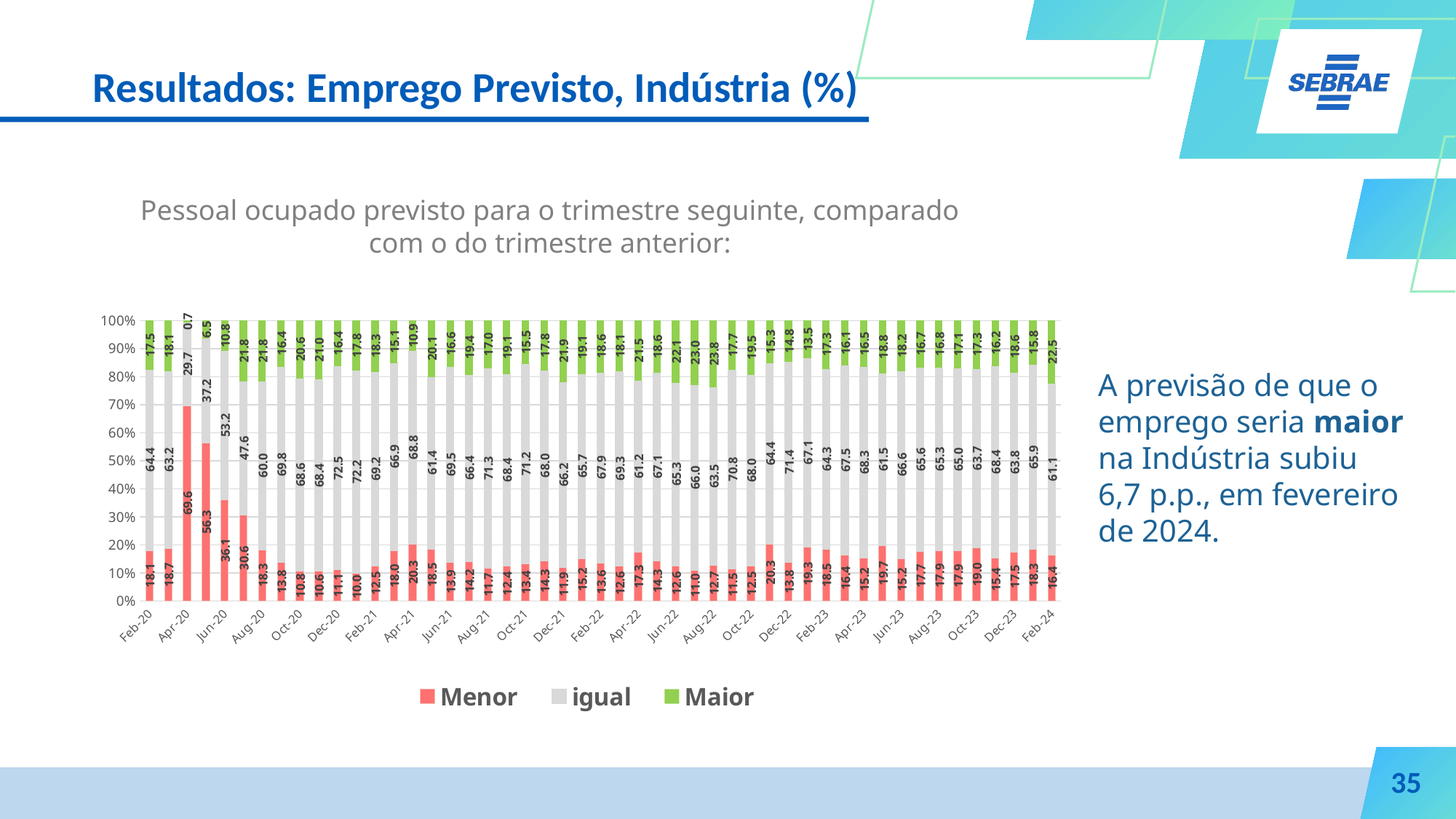
Which series is shown in green in the legend? Maior Does the Menor series rise or fall from Apr-20 to Oct-20? Fall What is the value of the igual series for Feb-20? 64.4 What type of chart is shown on the slide? Stacked bar chart How many series does the legend list? 3 What is the value of the Maior series for Feb-24? 22.5 What is the value of the Menor series for Apr-20? 69.6 What is the difference between the Maior value for Feb-24 and the Maior value for Feb-20? 5.0 What is the total of the stacked bar for Feb-24? 100 In which month does the Menor series reach its highest value? Apr-20 In which month does the Maior series reach its lowest value? Apr-20 Which is larger, the Menor value for Feb-20 or the Menor value for Feb-24? Feb-20